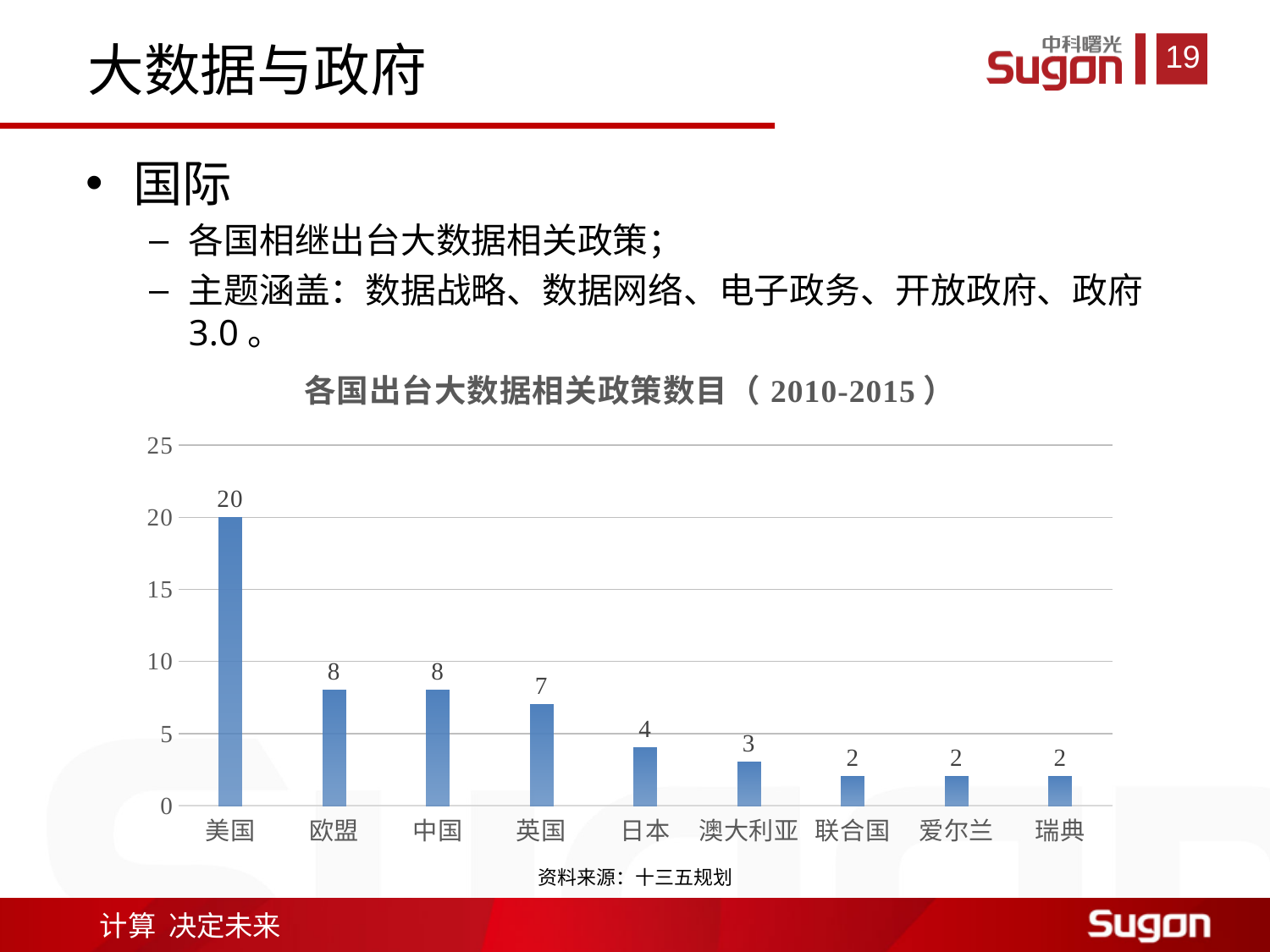
What kind of chart is shown on the slide? bar chart Which category has the highest value in the chart? 美国 What is the title of the chart? 各国出台大数据相关政策数目（2010-2015） What is the value for 日本 in the chart? 4 What is the value for 英国 in the chart? 7 Is the value for 美国 greater or less than 15? greater How many categories are shown on the x axis of the chart? 9 Which is larger, the value for 欧盟 or the value for 日本? 欧盟 What is the value for 澳大利亚 in the chart? 3 What is the difference between the values for 英国 and 日本? 3 What is the difference between the values for 美国 and 中国? 12 What is the value for 美国 in the chart? 20